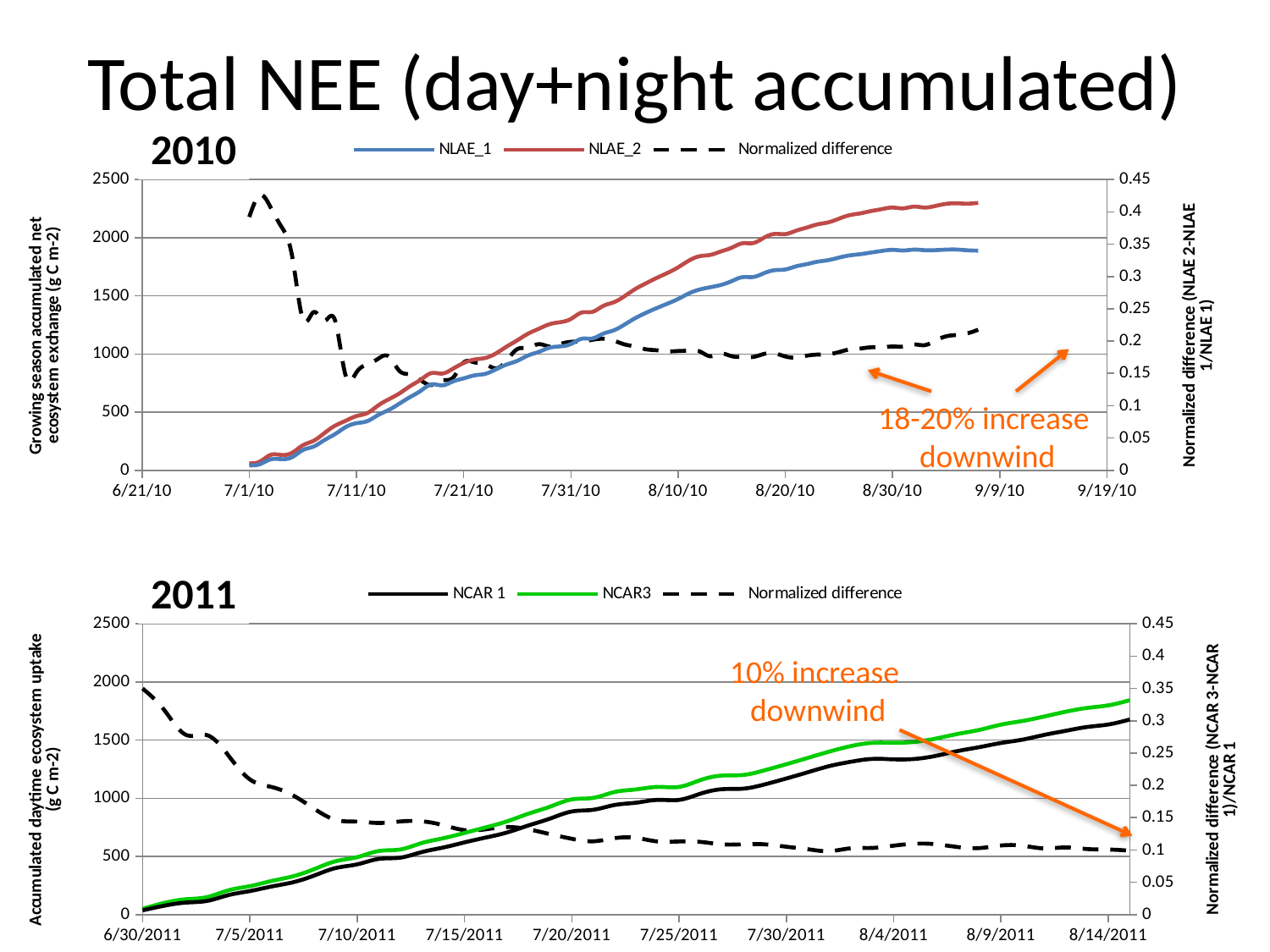
On the 2010 chart, does the Normalized difference series overall rise or fall from left to right? fall On the 2011 chart, which series ends higher at the right end of the x axis, NCAR 1 or NCAR3? NCAR3 On the 2010 chart, what kind of chart is shown? line chart On the 2011 chart, how many series does the legend list? 3 On the 2011 chart, does the NCAR3 series rise or fall along the x axis? rise On the 2011 chart, is the final value of the Normalized difference series greater or less than 0.15? less On the 2010 chart, which series ends higher at the right end of the x axis, NLAE_1 or NLAE_2? NLAE_2 On the 2010 chart, is the final value of NLAE_2 greater or less than 2000? greater On the 2011 chart, is the final value of NCAR 1 greater or less than 1500? greater On the 2011 chart, what are the three legend entries? NCAR 1, NCAR3, Normalized difference On the 2010 chart, how many series does the legend list? 3